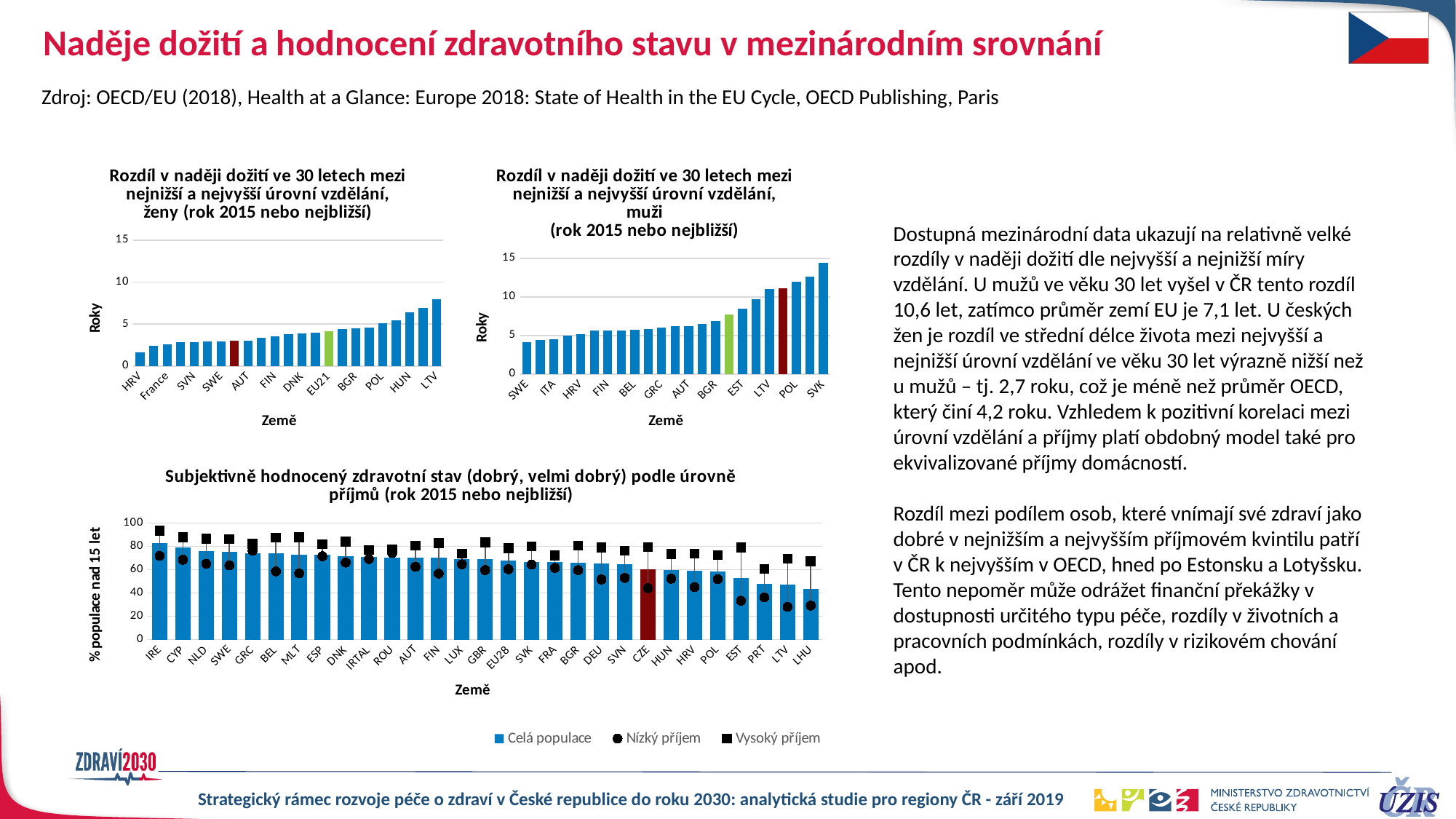
In the chart 'Subjektivně hodnocený zdravotní stav ... podle úrovně příjmů', how many countries/categories are shown on the x axis? 29 In the chart 'Subjektivně hodnocený zdravotní stav ... podle úrovně příjmů', how many series does the legend list? 3 In the chart 'Subjektivně hodnocený zdravotní stav ... podle úrovně příjmů', is the 'Celá populace' value for LHU greater or less than 60? less In the chart 'Subjektivně hodnocený zdravotní stav ... podle úrovně příjmů', which series is plotted with black circle markers? Nízký příjem What kind of chart is the chart titled 'Subjektivně hodnocený zdravotní stav (dobrý, velmi dobrý) podle úrovně příjmů'? combination bar and line chart In the chart 'Subjektivně hodnocený zdravotní stav ... podle úrovně příjmů', which category has the lowest 'Celá populace' bar? LHU In the chart 'Subjektivně hodnocený zdravotní stav ... podle úrovně příjmů', which category has the highest 'Celá populace' bar? IRE In the chart 'Rozdíl v naději dožití ve 30 letech mezi nejnižší a nejvyšší úrovní vzdělání, muži', which labelled country has the highest bar? SVK In the chart 'Rozdíl v naději dožití ve 30 letech mezi nejnižší a nejvyšší úrovní vzdělání, ženy', which labelled country has the lowest bar? HRV In the chart 'Rozdíl v naději dožití ve 30 letech mezi nejnižší a nejvyšší úrovní vzdělání, ženy', is the value for LTV greater or less than 5? greater In the chart 'Rozdíl v naději dožití ve 30 letech mezi nejnižší a nejvyšší úrovní vzdělání, muži', is the value for SVK greater or less than 10? greater In the chart 'Subjektivně hodnocený zdravotní stav ... podle úrovně příjmů', do the 'Celá populace' bars rise or fall from left to right along the x axis? fall